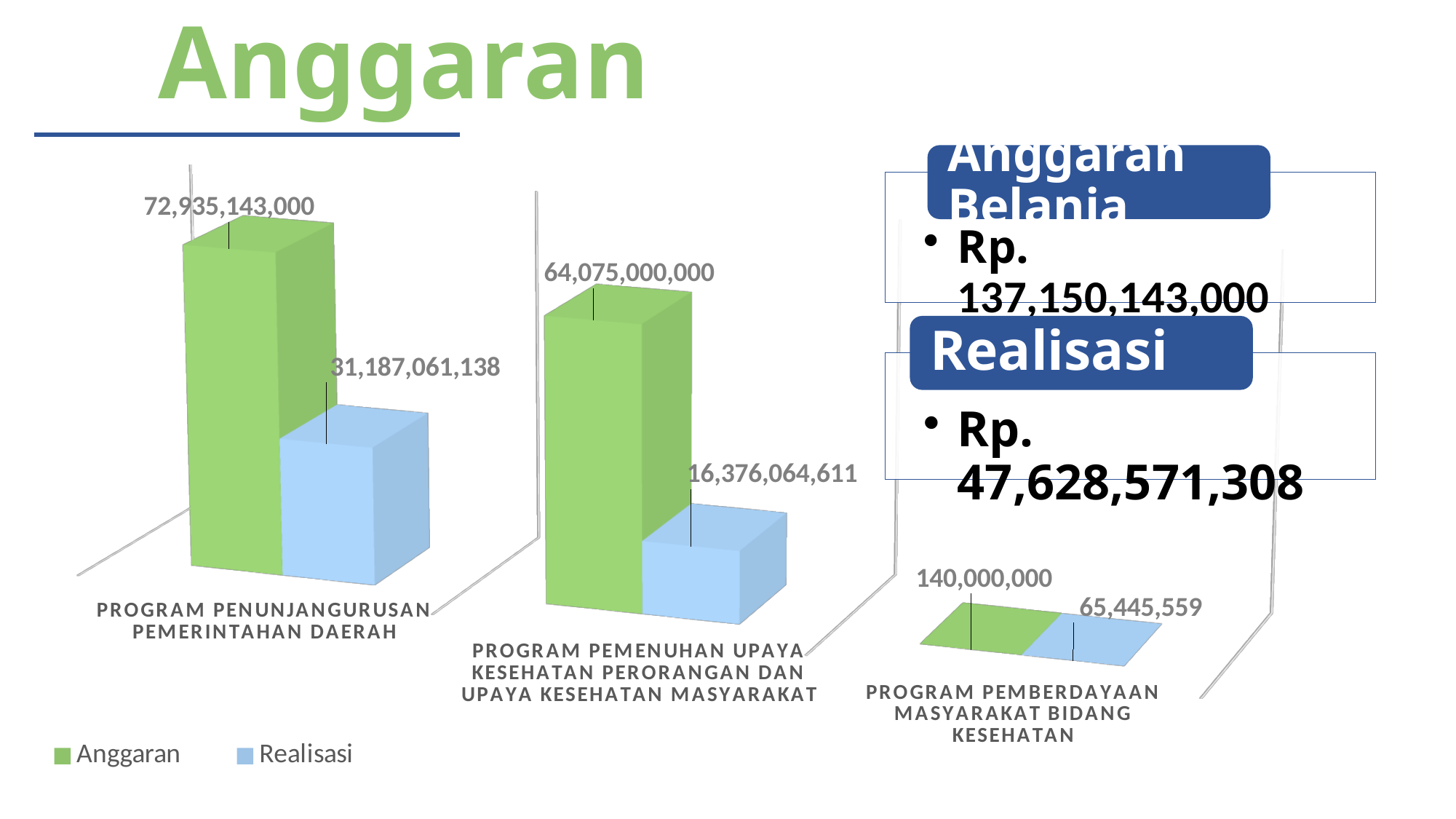
Which program has the lowest Realisasi value? PROGRAM PEMBERDAYAAN MASYARAKAT BIDANG KESEHATAN What is the Anggaran value for PROGRAM PEMBERDAYAAN MASYARAKAT BIDANG KESEHATAN? 140,000,000 What is the Anggaran value for PROGRAM PENUNJANG URUSAN PEMERINTAHAN DAERAH? 72,935,143,000 What is the Realisasi value for PROGRAM PEMBERDAYAAN MASYARAKAT BIDANG KESEHATAN? 65,445,559 Which colour represents the Realisasi series in the chart? Light blue What type of chart is shown on the slide? Bar chart How many series does the chart legend list? 2 How many program categories are plotted in the chart? 3 Which program has the highest Anggaran value? PROGRAM PENUNJANG URUSAN PEMERINTAHAN DAERAH What is the difference between Anggaran and Realisasi for PROGRAM PENUNJANG URUSAN PEMERINTAHAN DAERAH? 41,748,081,862 What is the Realisasi value for PROGRAM PEMENUHAN UPAYA KESEHATAN PERORANGAN DAN UPAYA KESEHATAN MASYARAKAT? 16,376,064,611 Which is larger for PROGRAM PEMENUHAN UPAYA KESEHATAN PERORANGAN DAN UPAYA KESEHATAN MASYARAKAT, Anggaran or Realisasi? Anggaran